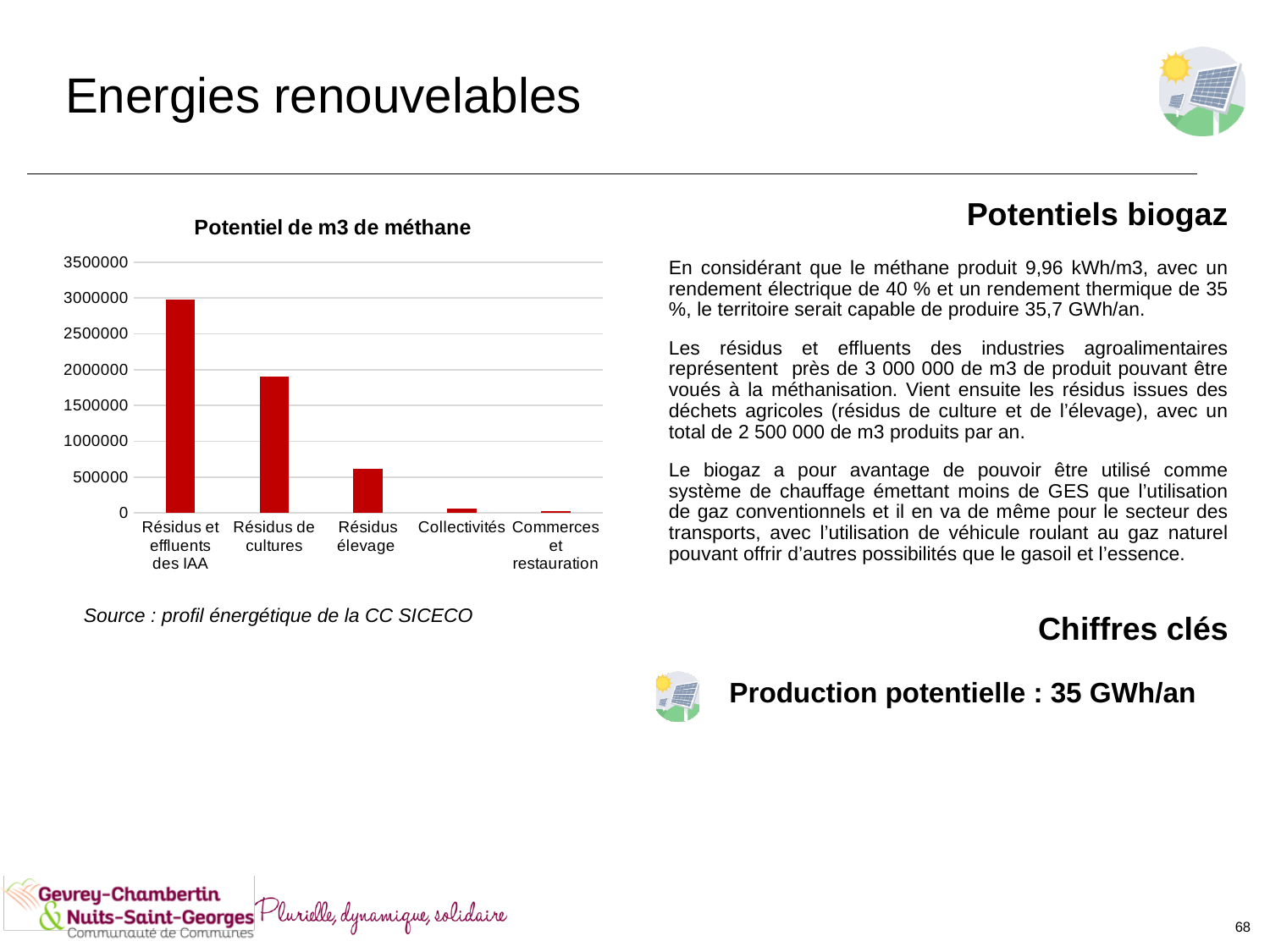
Which is larger, the value for Résidus élevage or the value for Collectivités? Résidus élevage What kind of chart is shown on the slide? bar chart Is the value for Résidus de cultures greater or less than 2000000? less What is the title of the chart? Potentiel de m3 de méthane What colour are the bars in the chart? red Which category has the highest value in the chart? Résidus et effluents des IAA How many categories are shown on the x axis of the chart? 5 Is the value for Résidus élevage greater or less than 500000? greater Do the values rise or fall from left to right along the x axis? fall Is the value for Collectivités greater or less than 500000? less Which is larger, the value for Résidus de cultures or the value for Résidus élevage? Résidus de cultures